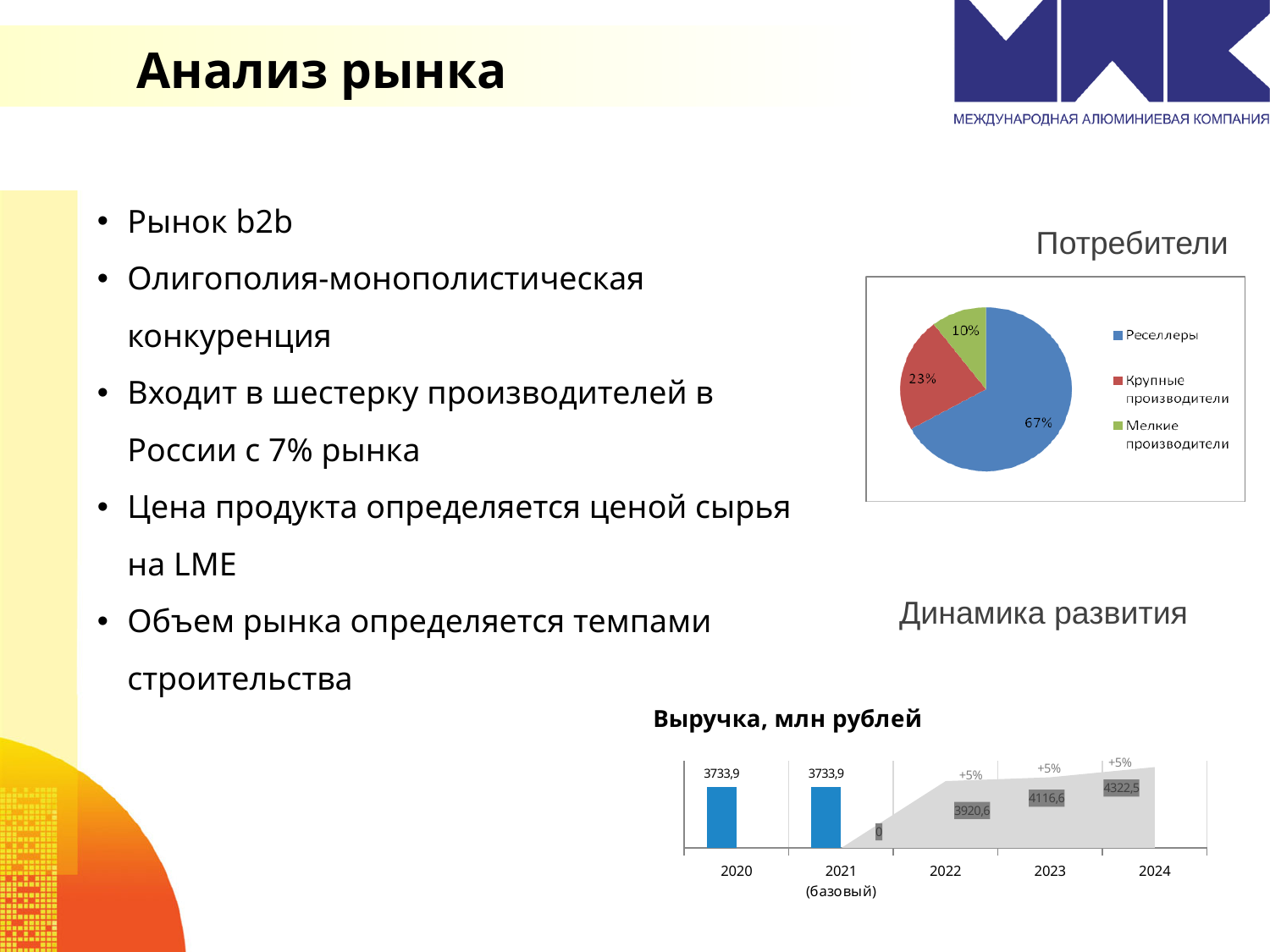
In the 'Выручка, млн рублей' chart, what is the value for 2022? 3920,6 In the 'Выручка, млн рублей' chart, do the values rise or fall from 2021 to 2024? Rise In the 'Потребители' pie chart, what share do Реселлеры have? 67% In the 'Потребители' pie chart, which category has the largest share? Реселлеры In the 'Выручка, млн рублей' chart, what is the value for 2024? 4322,5 In the 'Потребители' pie chart, which category has the smallest share? Мелкие производители In the 'Потребители' pie chart, how many categories does the legend list? 3 What type of chart is the 'Потребители' chart? Pie chart In the 'Потребители' pie chart, what share do Мелкие производители have? 10% In the 'Потребители' pie chart, what share do Крупные производители have? 23% In the 'Выручка, млн рублей' chart, what is the value for 2020? 3733,9 In the 'Выручка, млн рублей' chart, how many years are shown on the x axis? 5